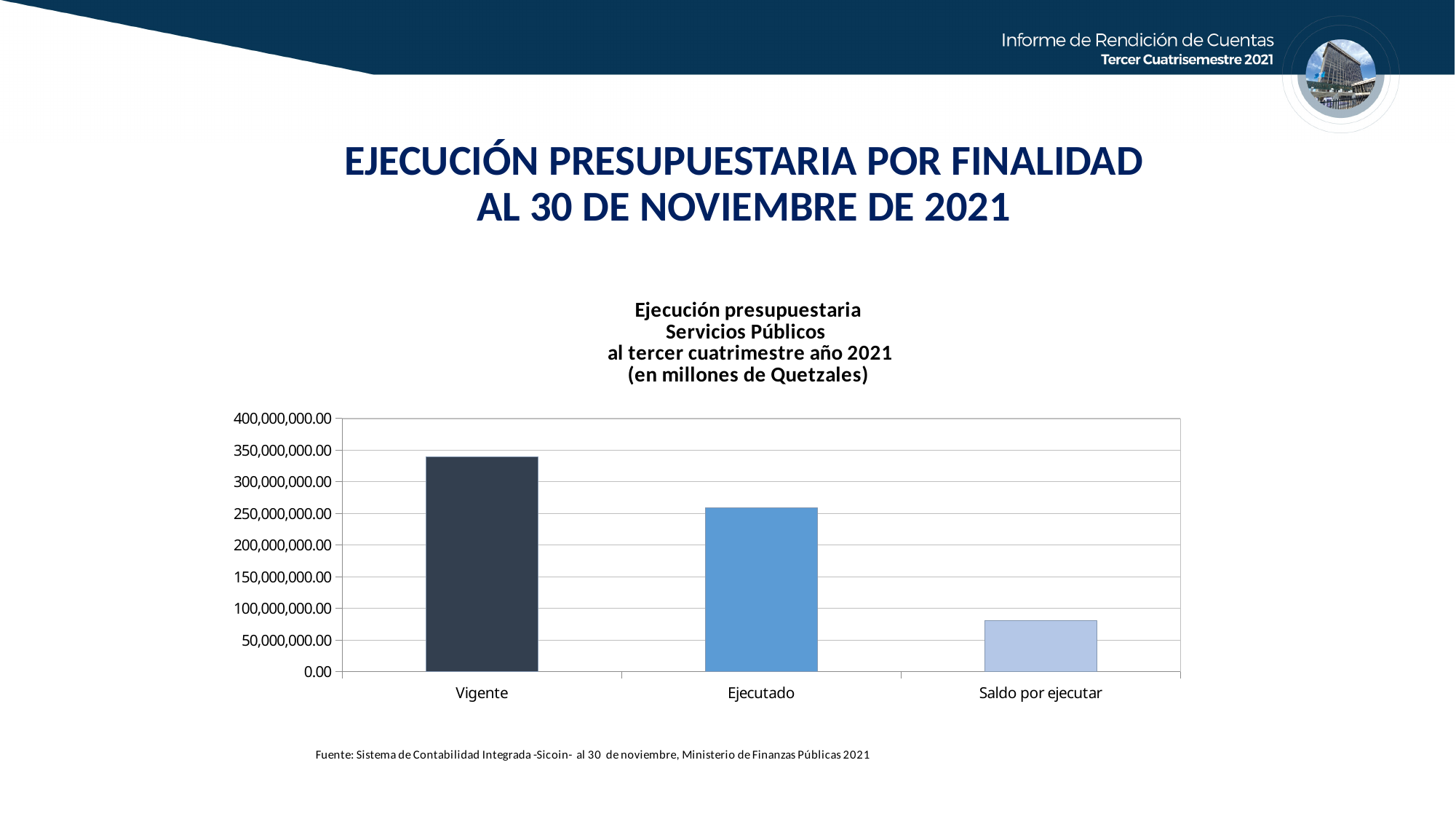
Do the bar values rise or fall from left to right across the x axis? fall Which category has the highest value in the chart? Vigente Which is larger, the value for Ejecutado or the value for Saldo por ejecutar? Ejecutado Is the value for Saldo por ejecutar greater or less than 50,000,000.00? greater What kind of chart is shown on the slide? bar chart How many categories are shown on the x axis of the chart? 3 Is the value for Ejecutado greater or less than 300,000,000.00? less Is the value for Vigente greater or less than 300,000,000.00? greater Which category has the lowest value in the chart? Saldo por ejecutar What is the maximum value shown on the vertical axis of the chart? 400,000,000.00 According to the chart title, in what unit are the values expressed? millones de Quetzales